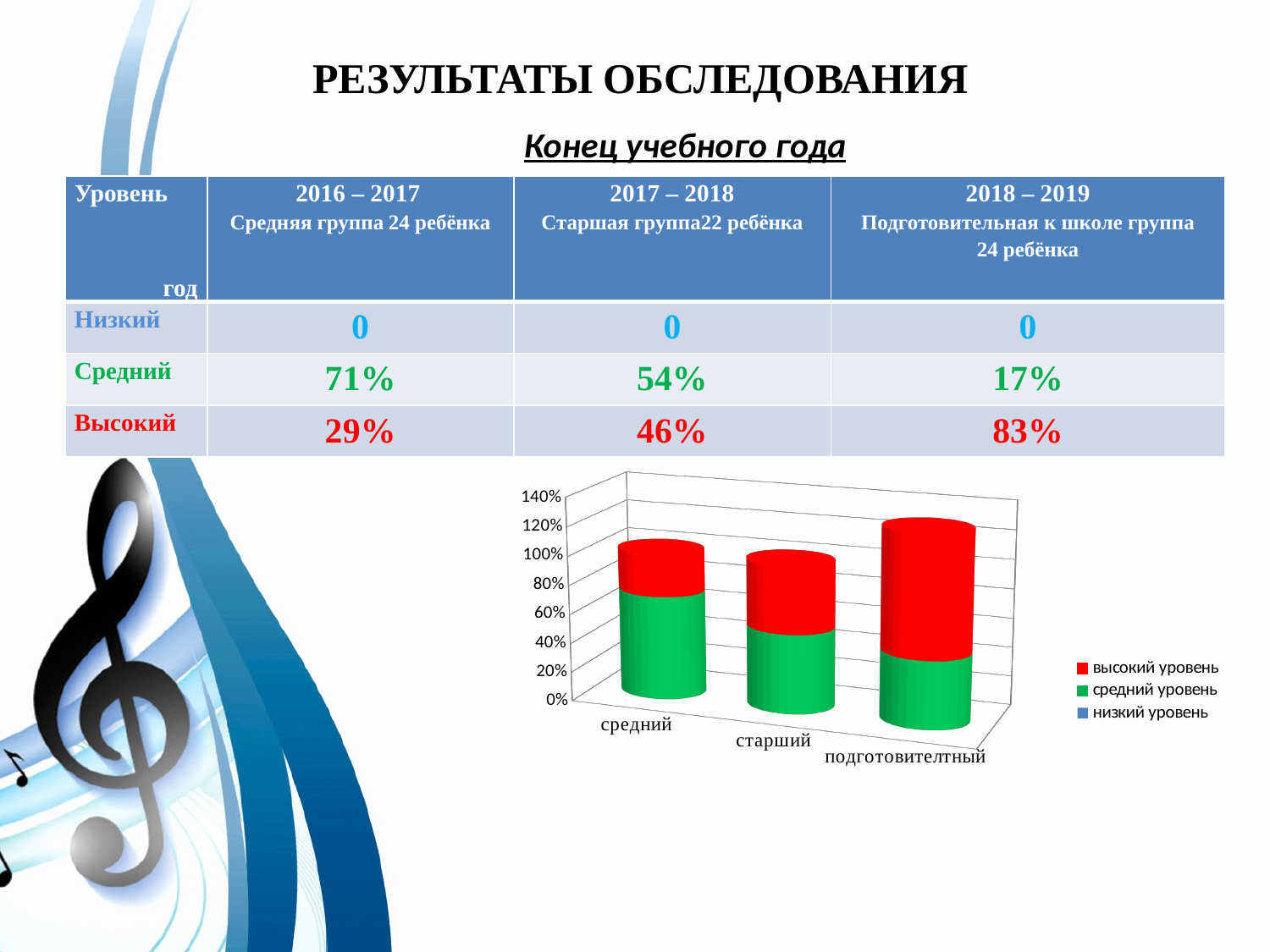
Which category has the largest red (высокий уровень) segment in the chart? подготовителтный What colour represents высокий уровень in the chart legend? red Which category has the tallest green (средний уровень) segment in the chart? средний How many categories are shown on the x axis of the chart? 3 Do the green (средний уровень) segments rise or fall from left to right across the categories? fall Which has the larger green (средний уровень) segment: средний or старший? средний What kind of chart is shown on the slide? stacked bar chart Which category has the smallest green (средний уровень) segment in the chart? подготовителтный Is the green (средний уровень) segment for старший greater or less than 40%? greater Is the green (средний уровень) segment for средний greater or less than 60%? greater How many series does the chart legend list? 3